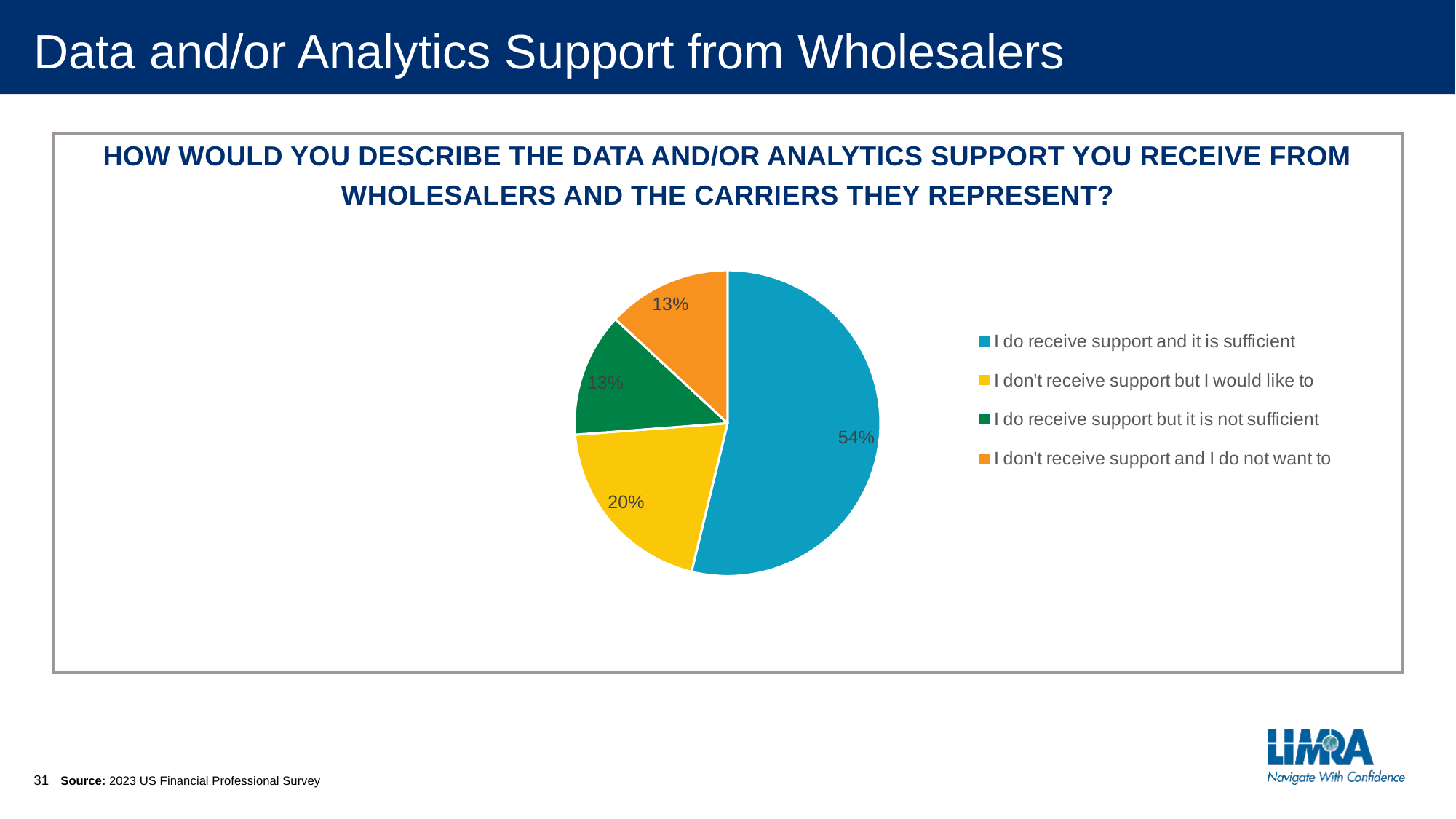
What share of respondents said "I do receive support but it is not sufficient"? 13% What is the difference in percentage points between "I do receive support and it is sufficient" and "I don't receive support but I would like to"? 34 percentage points How many slices does the pie chart have? 4 What share of respondents said "I don't receive support and I do not want to"? 13% Is the share for "I do receive support and it is sufficient" greater or less than 50%? greater Which response has the largest share of the pie? I do receive support and it is sufficient How many entries does the legend list? 4 What kind of chart is shown on the slide? Pie chart Which is larger: the share for "I don't receive support but I would like to" or the share for "I do receive support but it is not sufficient"? I don't receive support but I would like to What share of respondents said "I do receive support and it is sufficient"? 54% What share of respondents said "I don't receive support but I would like to"? 20% What colour is the slice for "I don't receive support and I do not want to"? Orange